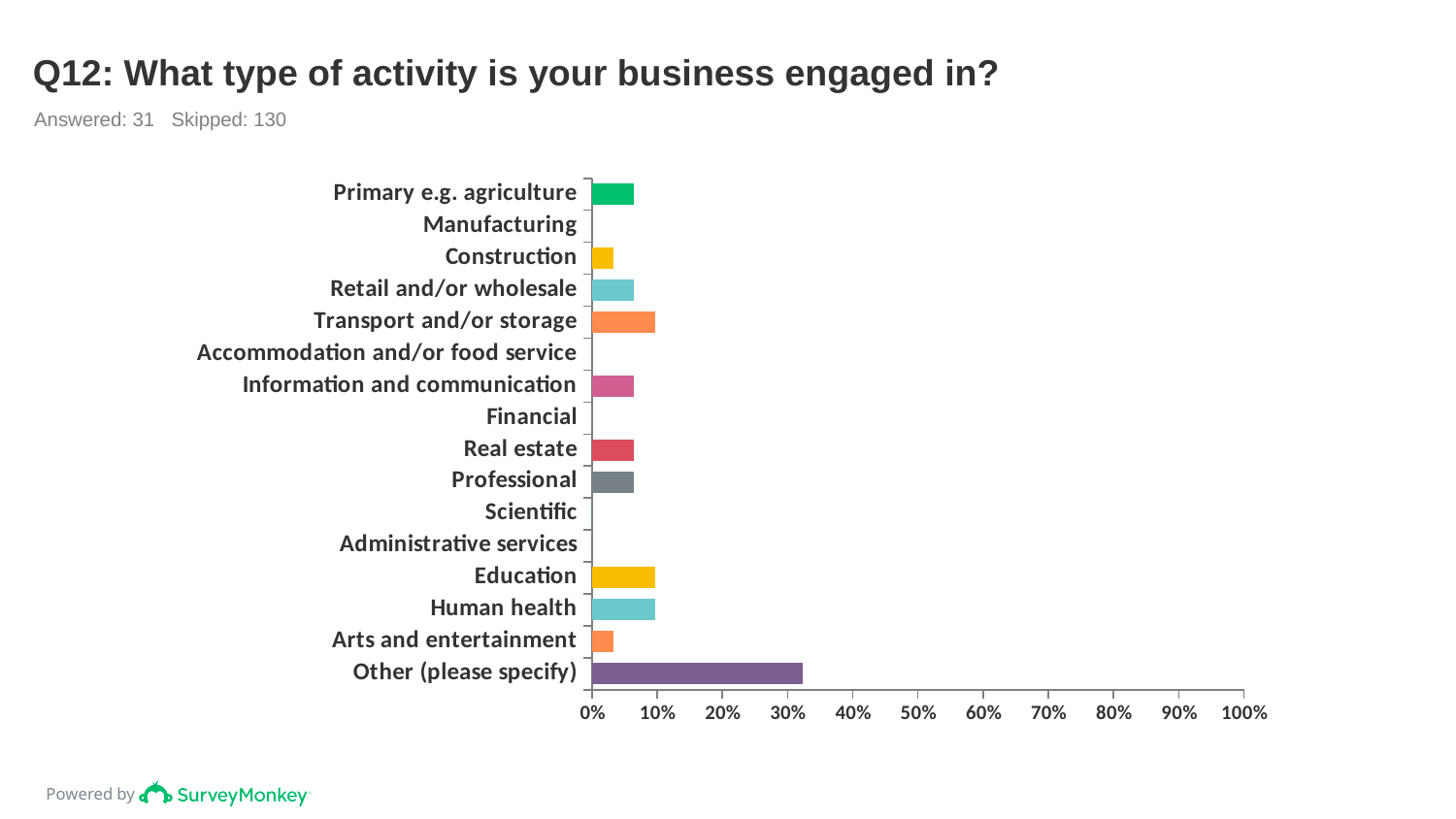
Which is larger, the value for Transport and/or storage or the value for Construction? Transport and/or storage Is the value for Education greater or less than 20%? less What kind of chart is shown on the slide? bar chart Is the value for Construction greater or less than 10%? less How many categories are plotted on the chart? 16 What is the maximum value shown on the horizontal axis? 100% What is the title of the chart? Q12: What type of activity is your business engaged in? Is the value for Other (please specify) greater or less than 20%? greater Which is larger, the value for Other (please specify) or the value for Education? Other (please specify) Which category has the highest value? Other (please specify) Which is larger, the value for Human health or the value for Arts and entertainment? Human health